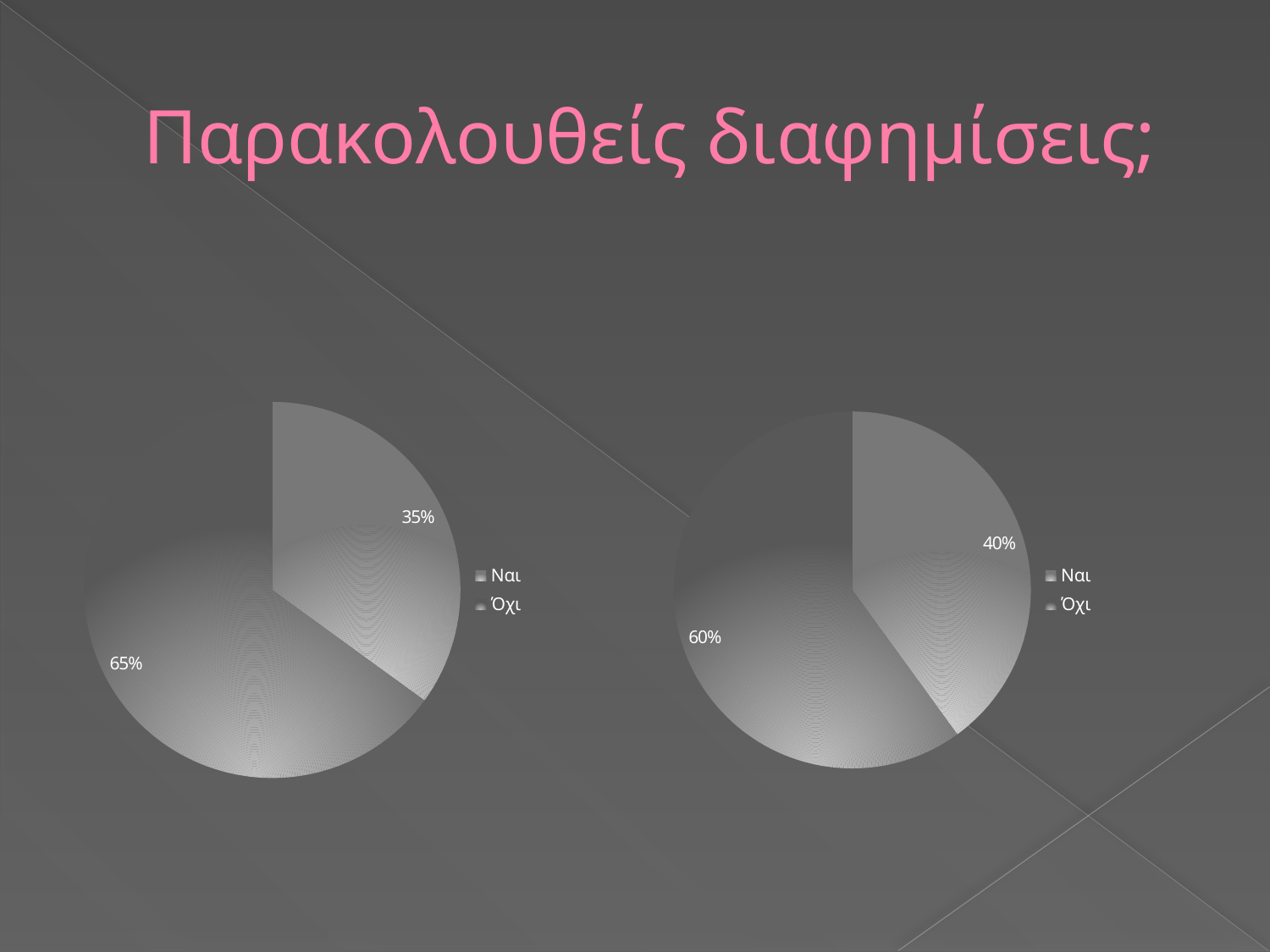
In the right pie chart, what percentage is shown for Ναι? 40% In the left pie chart, which category has the largest share? Όχι In the right pie chart, which category has the smallest share? Ναι In the right pie chart, what percentage is shown for Όχι? 60% In the left pie chart, what percentage is shown for Όχι? 65% What type of chart is shown on the right side of the slide? Pie chart What are the two legend entries in the left pie chart? Ναι and Όχι Which is larger: the Ναι share in the left pie chart or the Ναι share in the right pie chart? The right pie chart How many slices does the left pie chart have? 2 In the right pie chart, what is the difference between the Όχι and Ναι percentages? 20% In the left pie chart, what percentage is shown for Ναι? 35% In the left pie chart, what is the difference between the Όχι and Ναι percentages? 30%